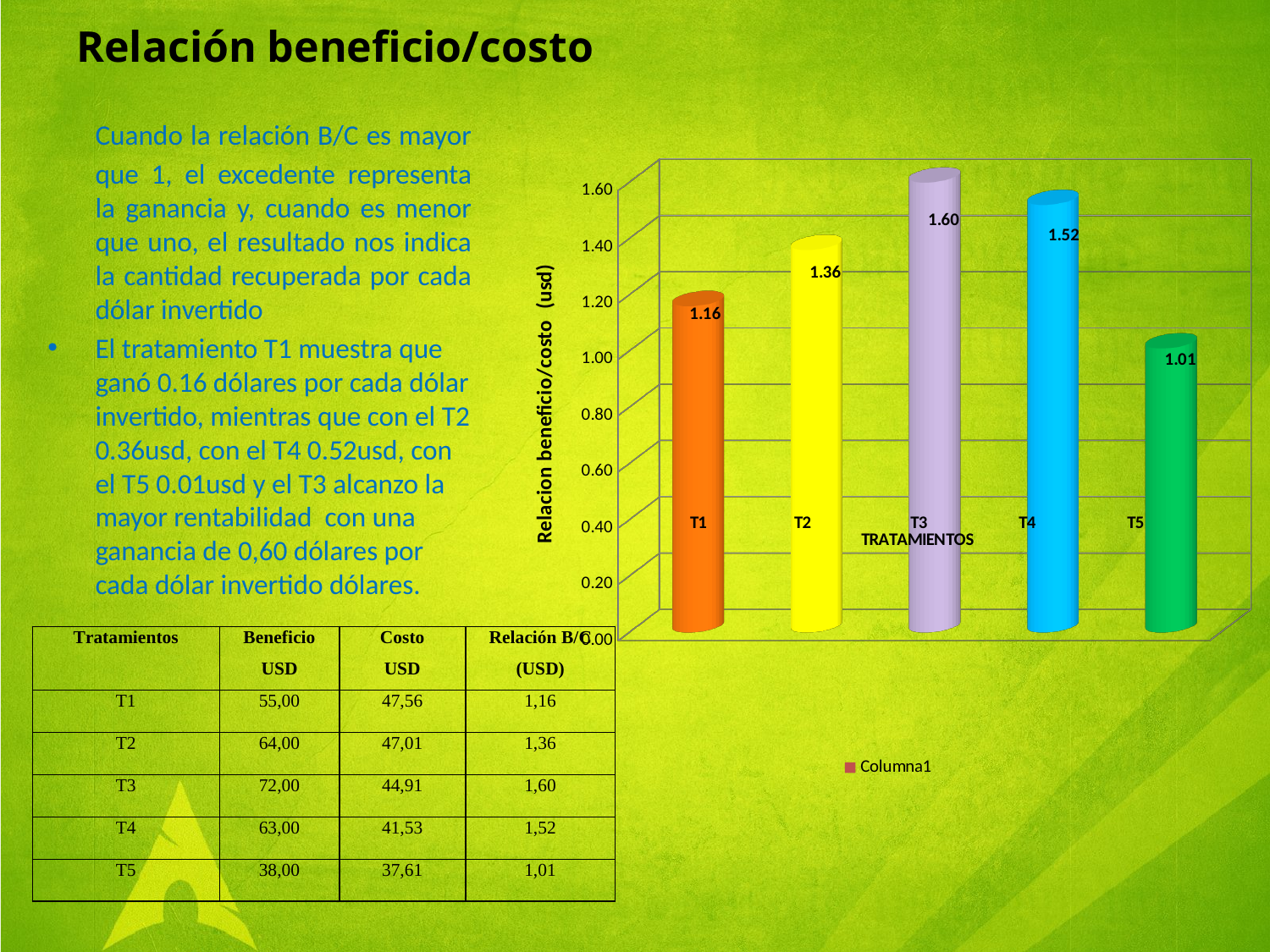
What is the value for T1 in the chart? 1.16 What is the difference between the values for T3 and T1? 0.44 What is the value for T5 in the chart? 1.01 What is the value for T3 in the chart? 1.60 What is the difference between the values for T4 and T2? 0.16 Which treatment has the lowest value in the chart? T5 Is the value for T5 greater or less than 1.20? less How many treatments are plotted in the chart? 5 What is the label on the vertical axis of the chart? Relacion beneficio/costo (usd) What kind of chart is shown on the slide? bar chart Which has a larger value, T2 or T4? T4 Which treatment has the highest value in the chart? T3